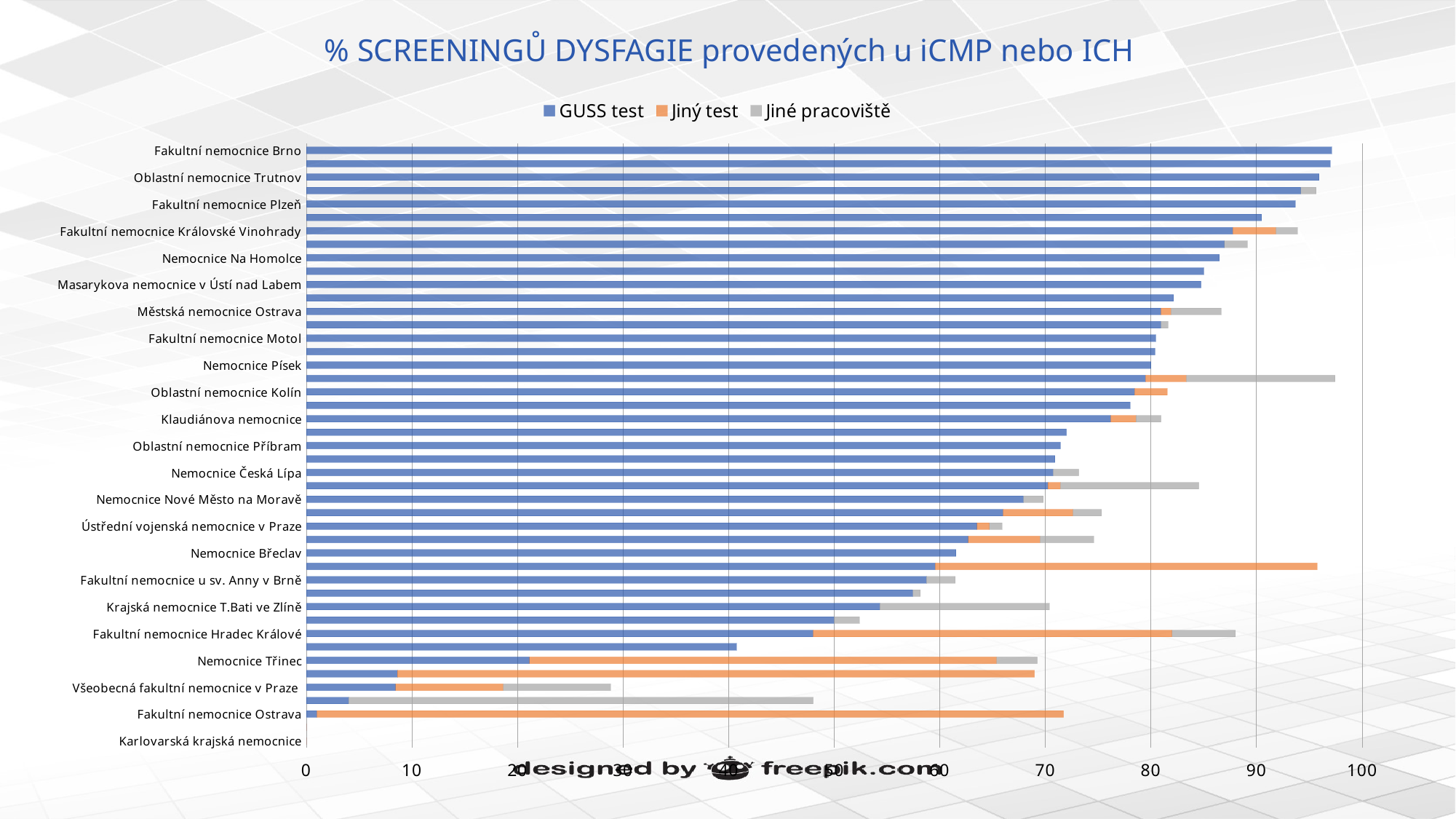
Is the GUSS test value for Fakultní nemocnice Ostrava greater or less than 10? less Is the GUSS test value for Nemocnice Třinec greater or less than 30? less What kind of chart is shown on the slide? Bar chart Which hospital has the longest 'Jiný test' segment? Fakultní nemocnice Ostrava How many series does the legend list? 3 Which colour represents the 'Jiný test' series in the legend? Orange What is the title of the chart? % SCREENINGŮ DYSFAGIE provedených u iCMP nebo ICH Is the GUSS test value for Fakultní nemocnice Hradec Králové greater or less than 60? less Going from the top of the chart to the bottom, do the GUSS test values increase or decrease? decrease Which has the larger GUSS test value, Fakultní nemocnice Plzeň or Nemocnice Břeclav? Fakultní nemocnice Plzeň Which hospital has the highest GUSS test value? Fakultní nemocnice Brno